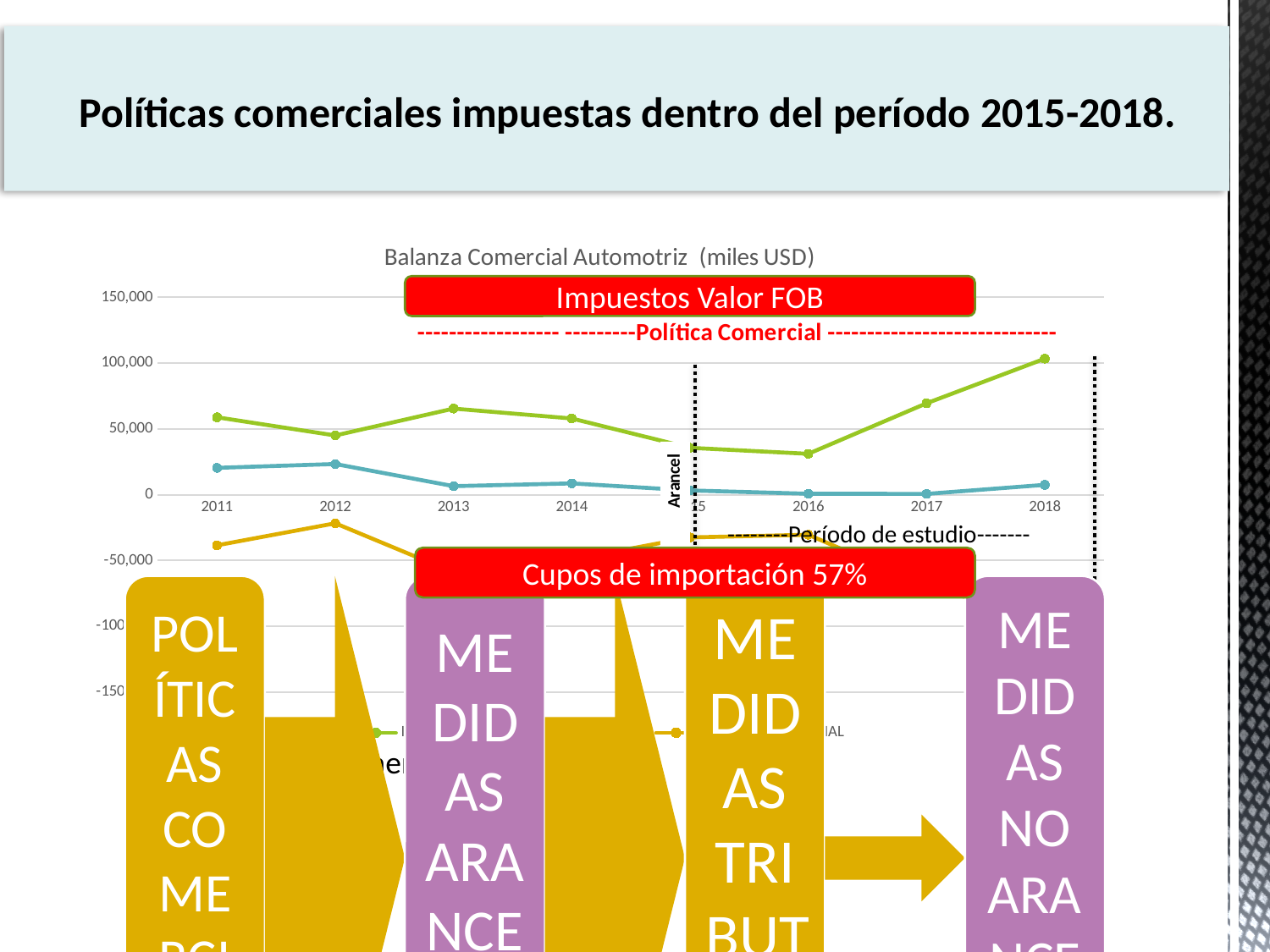
What percentage is stated in the red 'Cupos de importación' annotation on the chart? 57% In which year does the green line reach its highest value? 2018 What is the first year shown on the x axis of the chart? 2011 What kind of chart is shown on the slide? line chart What is the title of the chart? Balanza Comercial Automotriz (miles USD) How many years are shown along the x axis of the chart? 8 Is the value of the green line in 2013 greater or less than 50,000? greater Which is larger for the green line, the value in 2011 or the value in 2012? 2011 Does the green line rise or fall between 2016 and 2018? rise In which year does the green line reach its lowest value? 2016 Is the value of the teal line in 2013 greater or less than 50,000? less What is the last year shown on the x axis of the chart? 2018